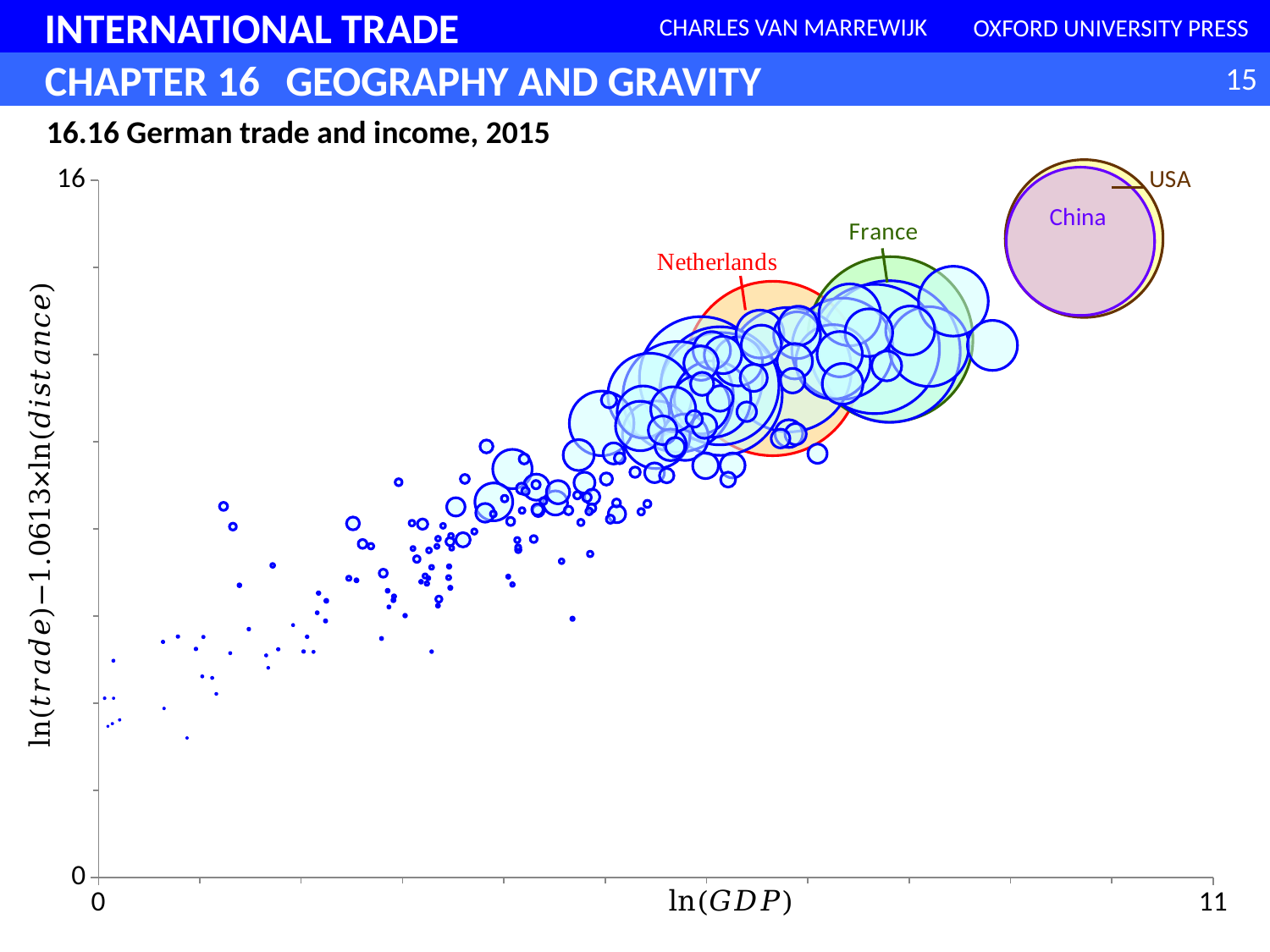
Which has the larger ln(GDP) value, Netherlands or France? France What is the title of the chart? 16.16 German trade and income, 2015 How many countries are labelled by name on the chart? 4 What is the label of the x axis? ln(GDP) Which has the larger ln(GDP) value, France or China? China What is the maximum value shown on the y axis? 16 Which is higher on the y axis, Netherlands or China? China Which labelled country has the lowest ln(GDP) value? Netherlands Do the plotted values generally rise or fall as ln(GDP) increases along the x axis? Rise What is the maximum value shown on the x axis? 11 Is the ln(GDP) value for China greater or less than 11? less What kind of chart is shown on the slide? Bubble (scatter) chart